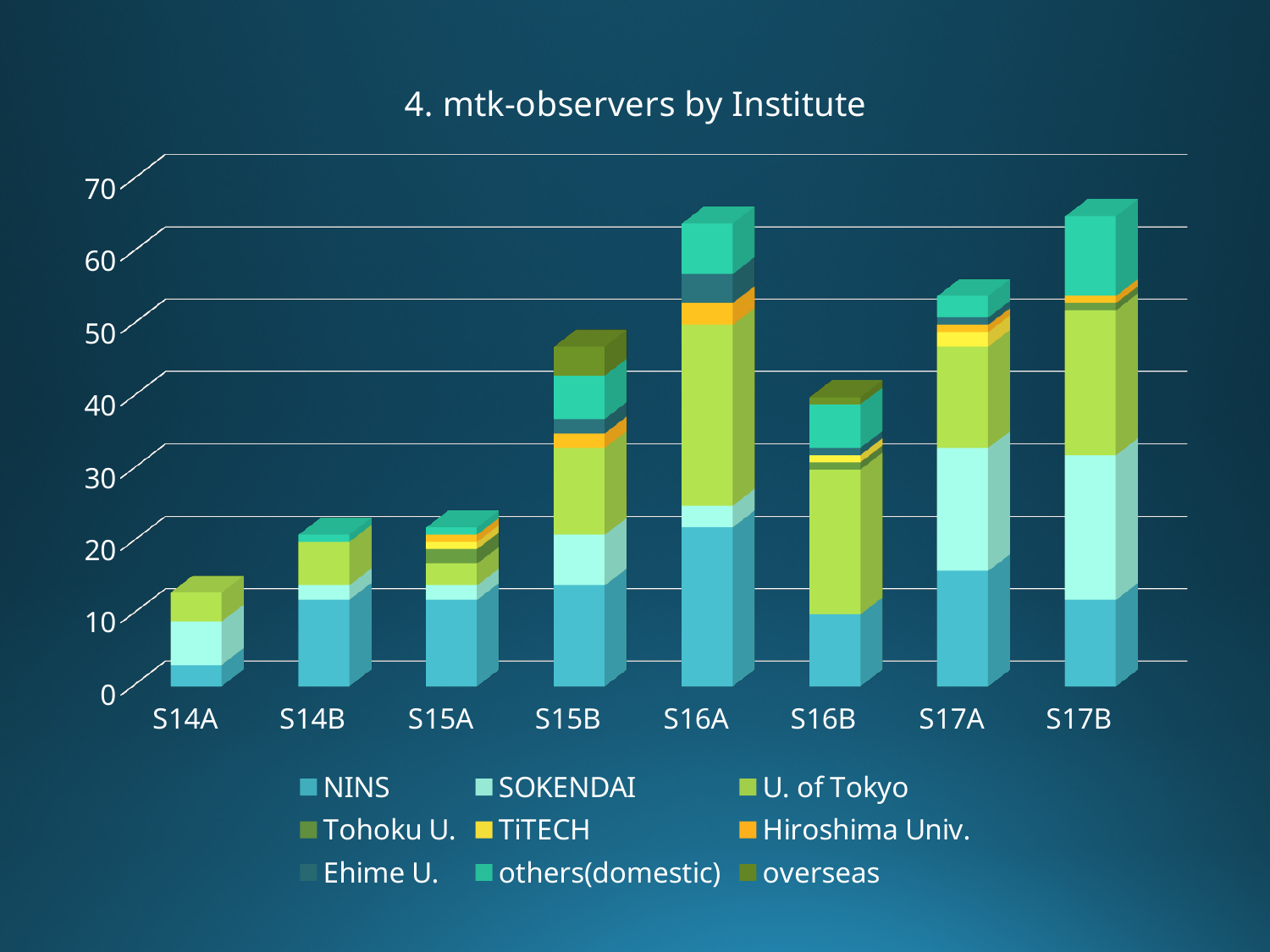
How many categories (semesters) are shown on the x axis? 8 Which category has the lowest total bar? S14A Is the total for S16A greater or less than 60? greater Which has the larger total bar, S15B or S16B? S15B What is the title of the chart? 4. mtk-observers by Institute Is the total for S14A greater or less than 20? less How many series does the legend list? 9 What kind of chart is shown on the slide? Stacked bar chart Do the total bar heights rise or fall from S14A to S16A? rise Which has the larger total bar, S14A or S14B? S14B Is the total for S15B greater or less than 40? greater